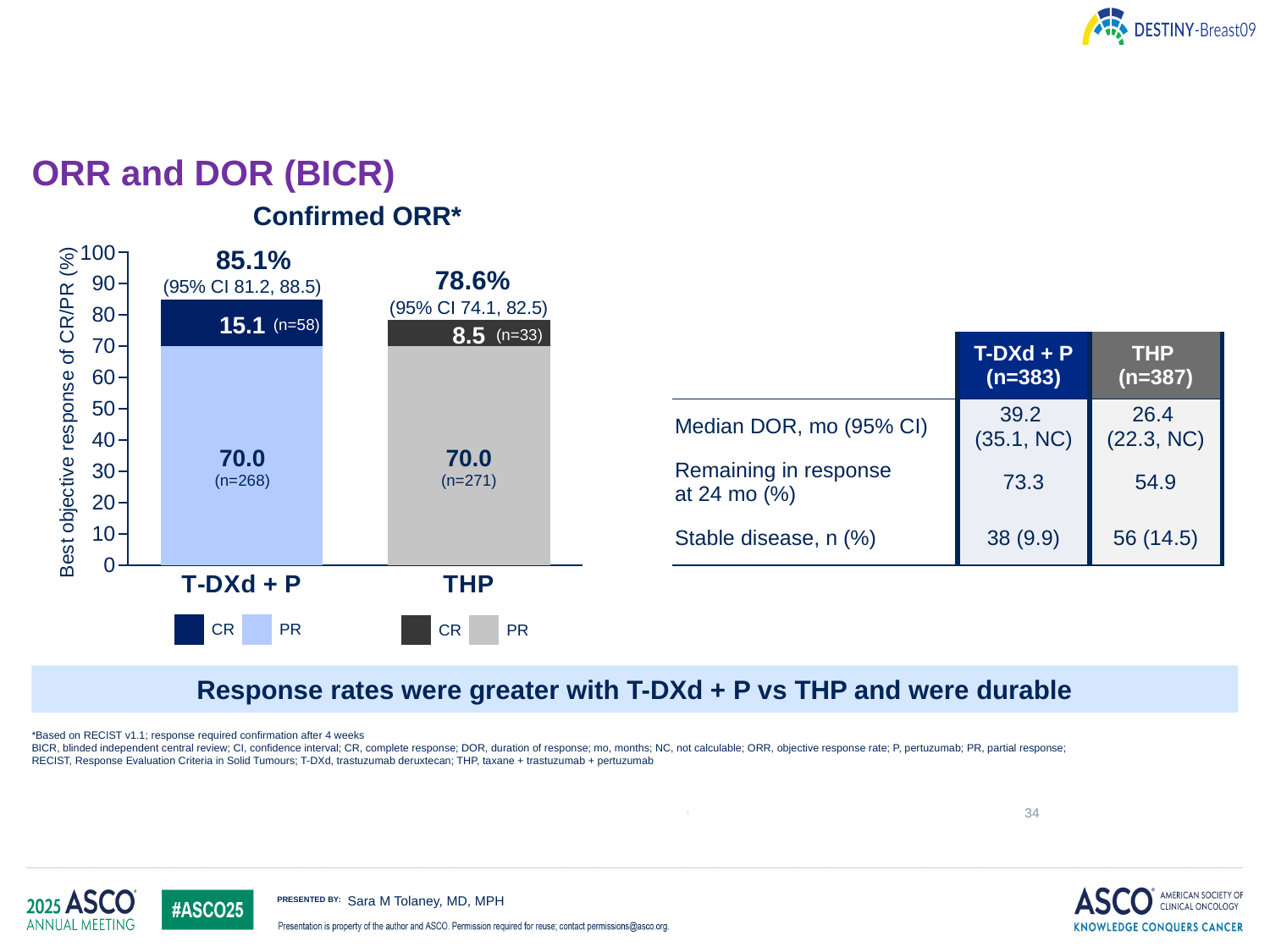
What is the CR value for the T-DXd + P bar? 15.1 What is the CR value for the THP bar? 8.5 What type of chart is the Confirmed ORR chart? Stacked bar chart What is the confirmed ORR for THP in the Confirmed ORR chart? 78.6% Which treatment arm has the higher confirmed ORR? T-DXd + P What is the 95% CI shown for the T-DXd + P confirmed ORR? 81.2, 88.5 What is the confirmed ORR for T-DXd + P in the Confirmed ORR chart? 85.1% What is the PR value for the THP bar? 70.0 Is the CR value larger for T-DXd + P or for THP? T-DXd + P What is the difference in confirmed ORR between T-DXd + P and THP? 6.5% What is the difference in CR between T-DXd + P and THP? 6.6 How many treatment arms are shown on the x axis of the Confirmed ORR chart? 2